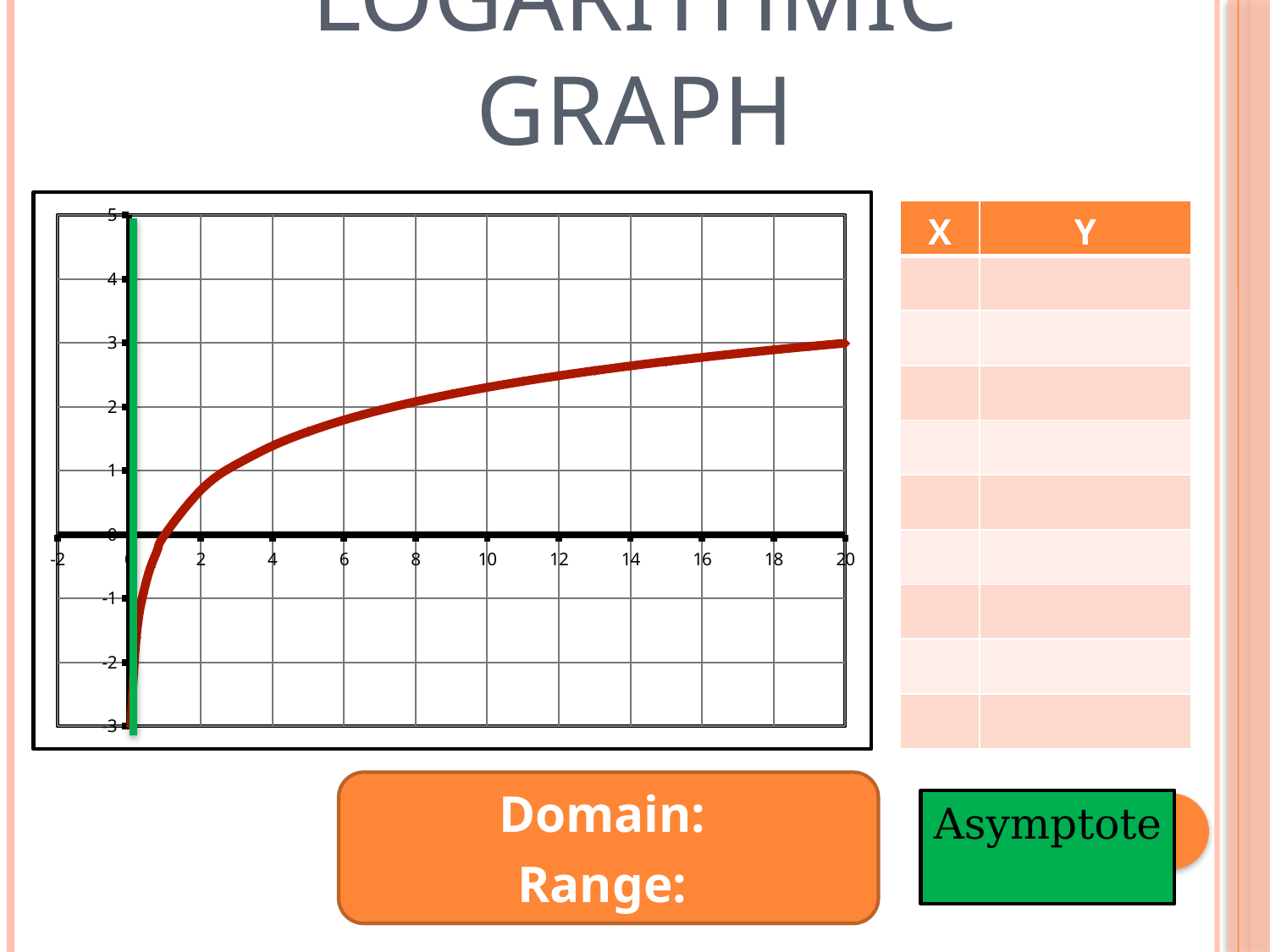
What kind of chart is shown on the slide? line chart Is the value of the red curve at x = 16 greater or less than 3? less Does the red curve rise or fall as x increases from 2 to 20? rise Is the value of the red curve at x = 4 greater or less than 1? greater What is the highest value labelled on the x axis? 20 Is the value of the red curve at x = 10 greater or less than 2? greater What colour is the vertical asymptote line drawn on the chart? green